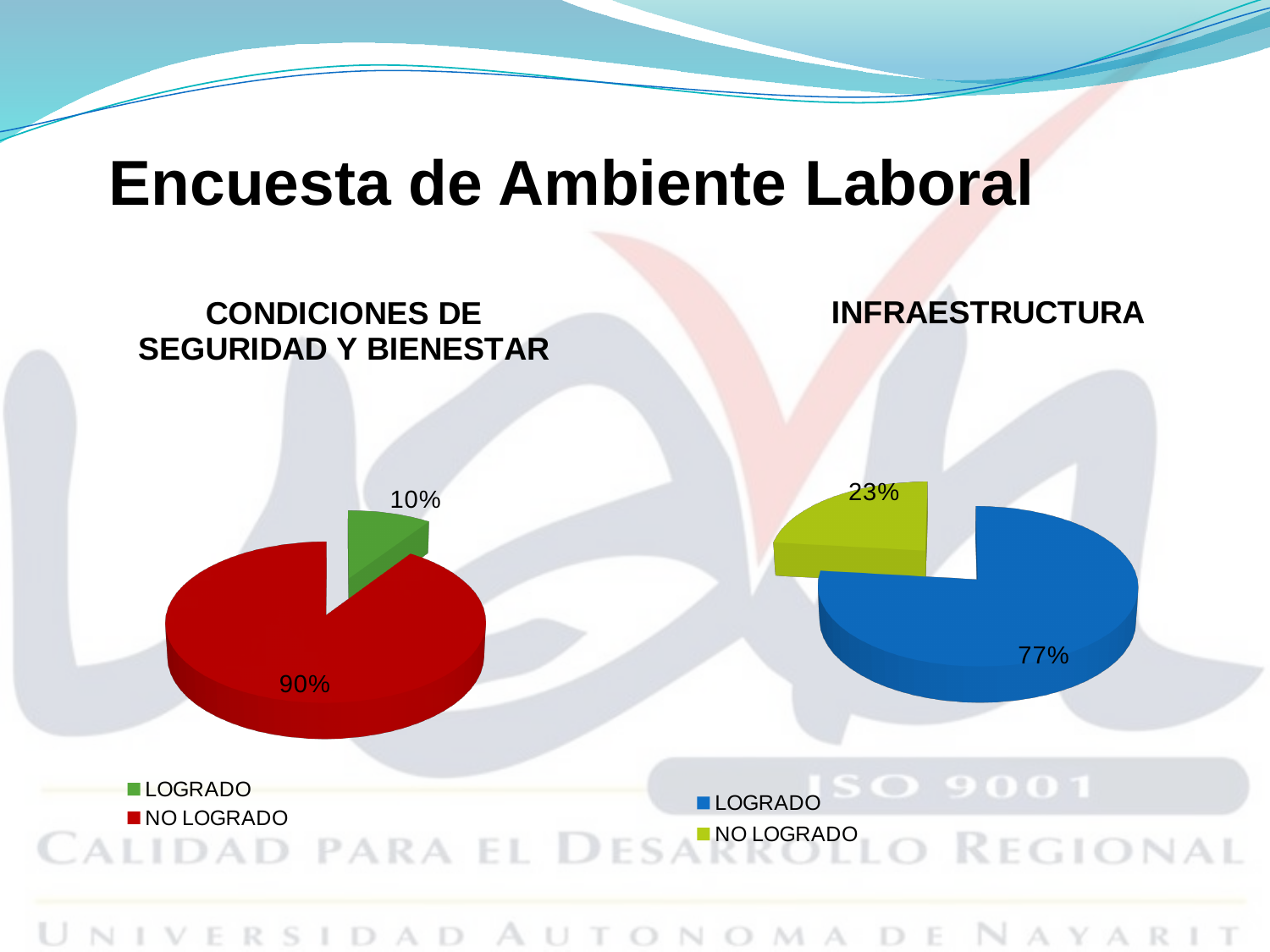
In the INFRAESTRUCTURA chart, what percentage is LOGRADO? 77% How many slices does the CONDICIONES DE SEGURIDAD Y BIENESTAR chart have? 2 In the INFRAESTRUCTURA chart, what is the difference between the LOGRADO and NO LOGRADO percentages? 54% What type of chart is used for INFRAESTRUCTURA? Pie chart In the CONDICIONES DE SEGURIDAD Y BIENESTAR chart, what percentage is LOGRADO? 10% In the CONDICIONES DE SEGURIDAD Y BIENESTAR chart, which category has the largest slice? NO LOGRADO In the INFRAESTRUCTURA chart, what colour is the LOGRADO slice? Blue Which chart has the larger LOGRADO share, CONDICIONES DE SEGURIDAD Y BIENESTAR or INFRAESTRUCTURA? INFRAESTRUCTURA In the INFRAESTRUCTURA chart, what percentage is NO LOGRADO? 23% In the CONDICIONES DE SEGURIDAD Y BIENESTAR chart, what percentage is NO LOGRADO? 90% In the CONDICIONES DE SEGURIDAD Y BIENESTAR chart, what is the difference between the NO LOGRADO and LOGRADO percentages? 80% In the INFRAESTRUCTURA chart, which category has the smallest slice? NO LOGRADO